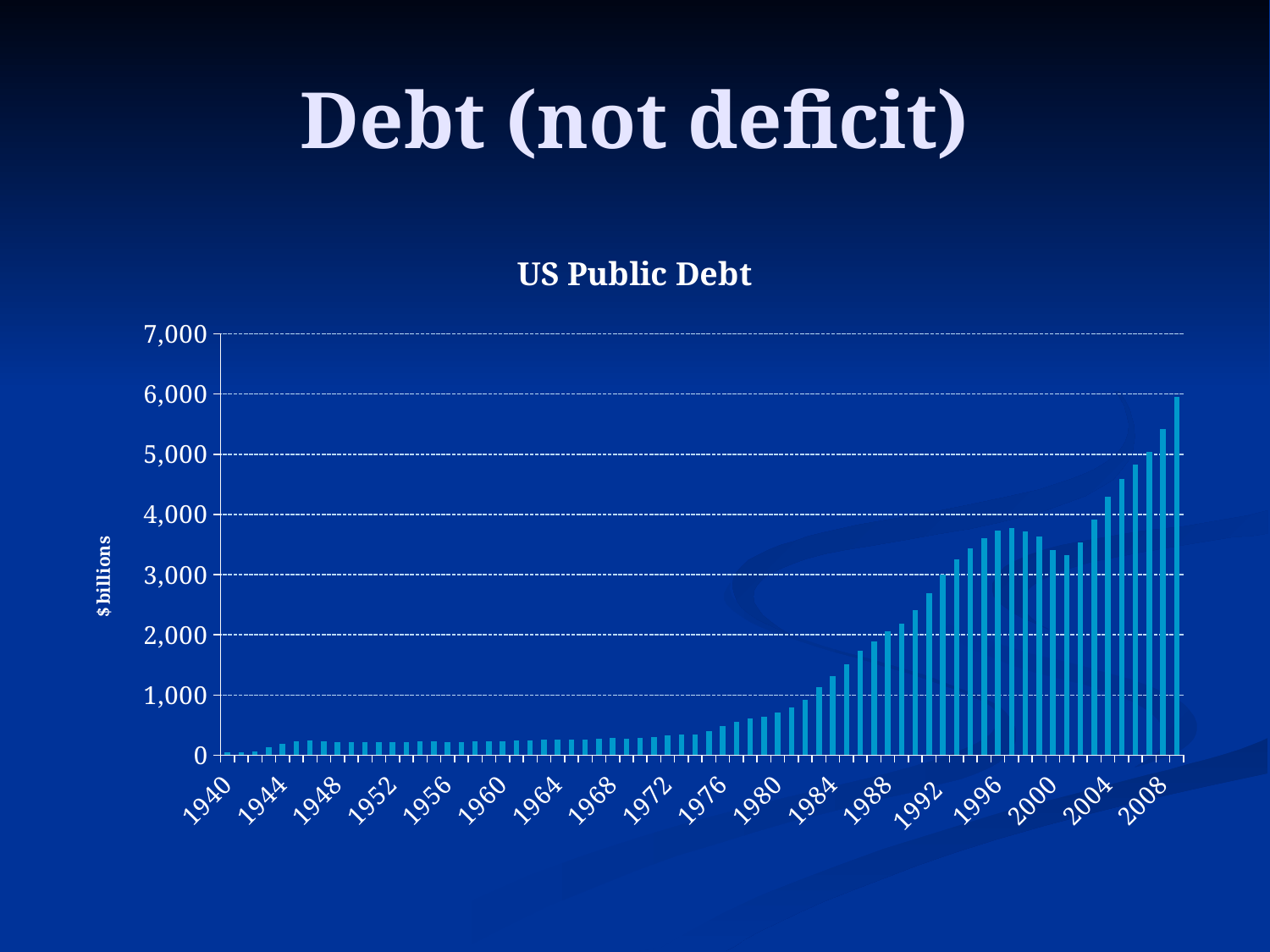
Is the value for 1976 greater or less than 1,000? less Which year has the larger value, 1940 or 1944? 1944 Is the value for 2008 greater or less than 4,000? greater Is the value for 1996 greater or less than 3,000? greater What is the title of the chart? US Public Debt Which year has the larger value, 1980 or 2000? 2000 Overall, do the values rise or fall from 1940 to the right end of the x axis? rise What is the label on the vertical axis of the chart? $ billions What kind of chart is shown on the slide? bar chart